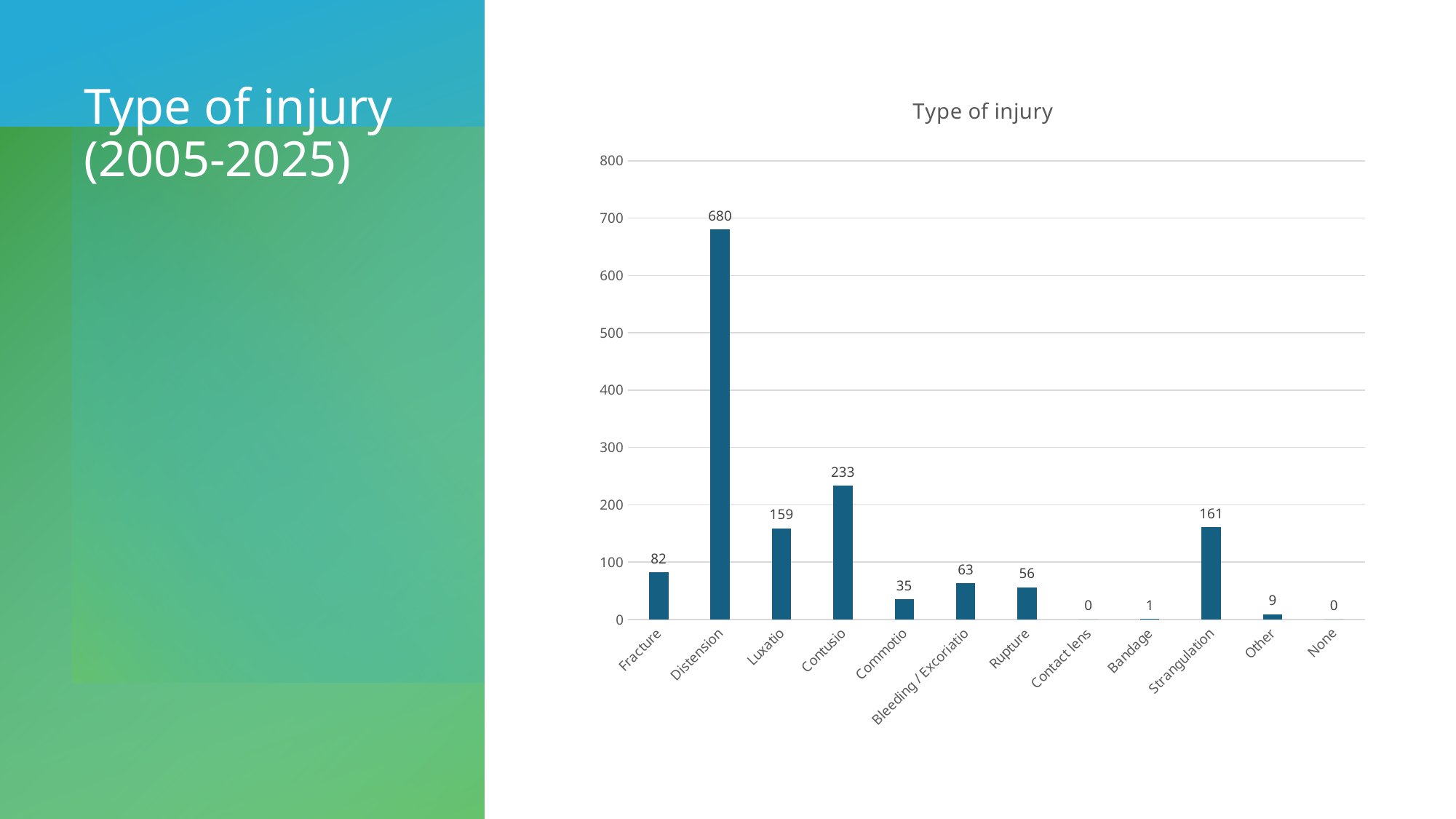
What is the difference between the values for Bleeding / Excoriatio and Rupture? 7 What is the difference between the values for Contusio and Luxatio? 74 Which type of injury has the highest value? Distension What is the value for Strangulation? 161 What is the value for Bandage? 1 What is the value for Commotio? 35 What is the title of the chart? Type of injury Is the value for Contusio greater or less than 200? greater How many categories are shown on the x axis? 12 What kind of chart is shown on the slide? Bar chart Which is larger, the value for Fracture or the value for Rupture? Fracture What is the value for Distension? 680